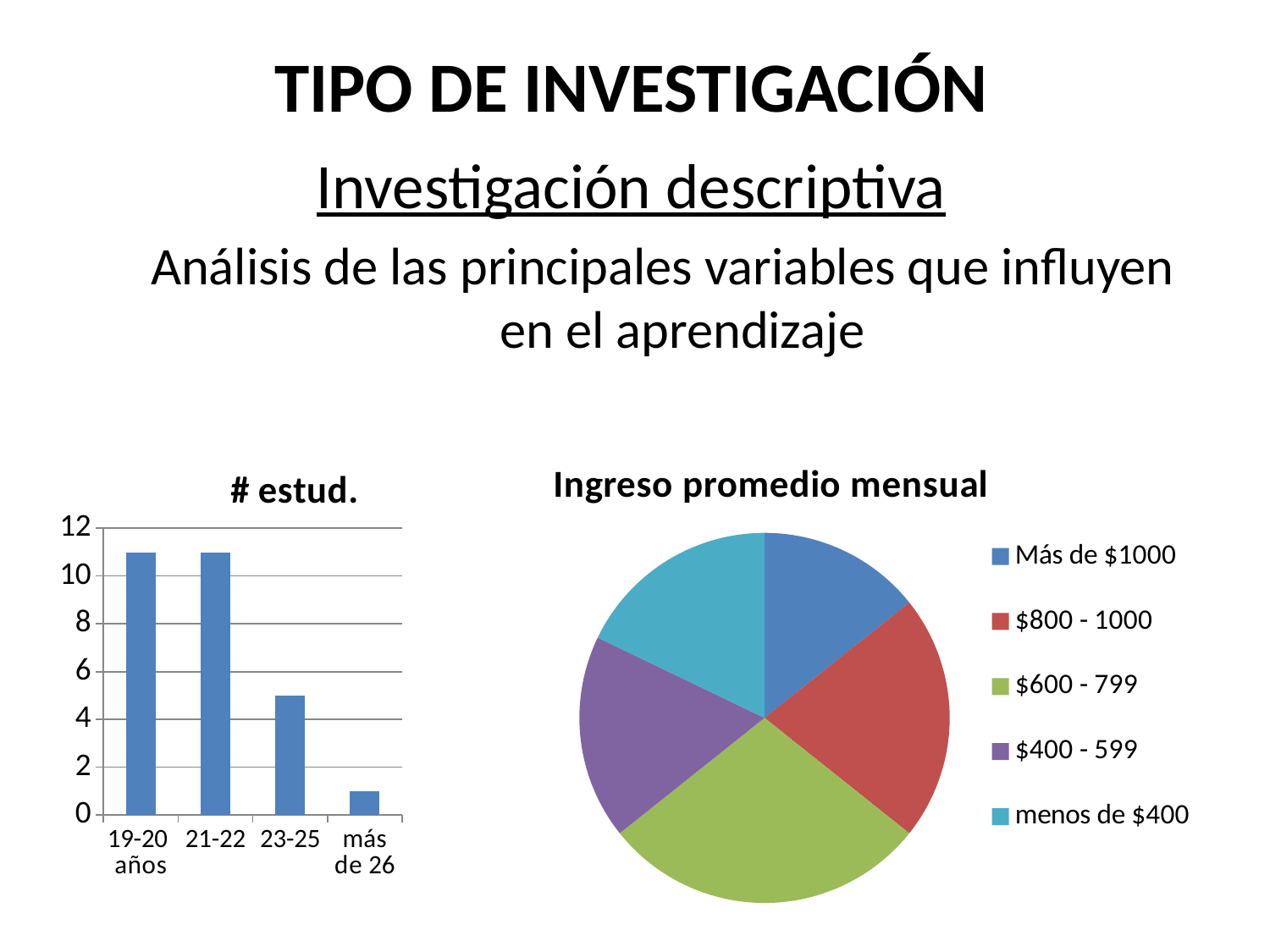
In the '# estud.' chart, is the value for 23-25 greater or less than 4? greater In the '# estud.' chart, which is larger, the value for 23-25 or the value for más de 26? 23-25 In the '# estud.' chart, what kind of chart is it? bar chart In the 'Ingreso promedio mensual' chart, which income category has the largest slice? $600 - 799 In the 'Ingreso promedio mensual' chart, which legend entry is shown in green? $600 - 799 In the 'Ingreso promedio mensual' chart, how many entries does the legend list? 5 In the '# estud.' chart, is the value for más de 26 greater or less than 2? less In the '# estud.' chart, do the values rise or fall from left to right along the x axis? fall In the 'Ingreso promedio mensual' chart, what kind of chart is it? pie chart In the '# estud.' chart, which age category has the lowest value? más de 26 In the '# estud.' chart, how many age categories are shown on the x axis? 4 In the '# estud.' chart, is the value for 19-20 años greater or less than 10? greater